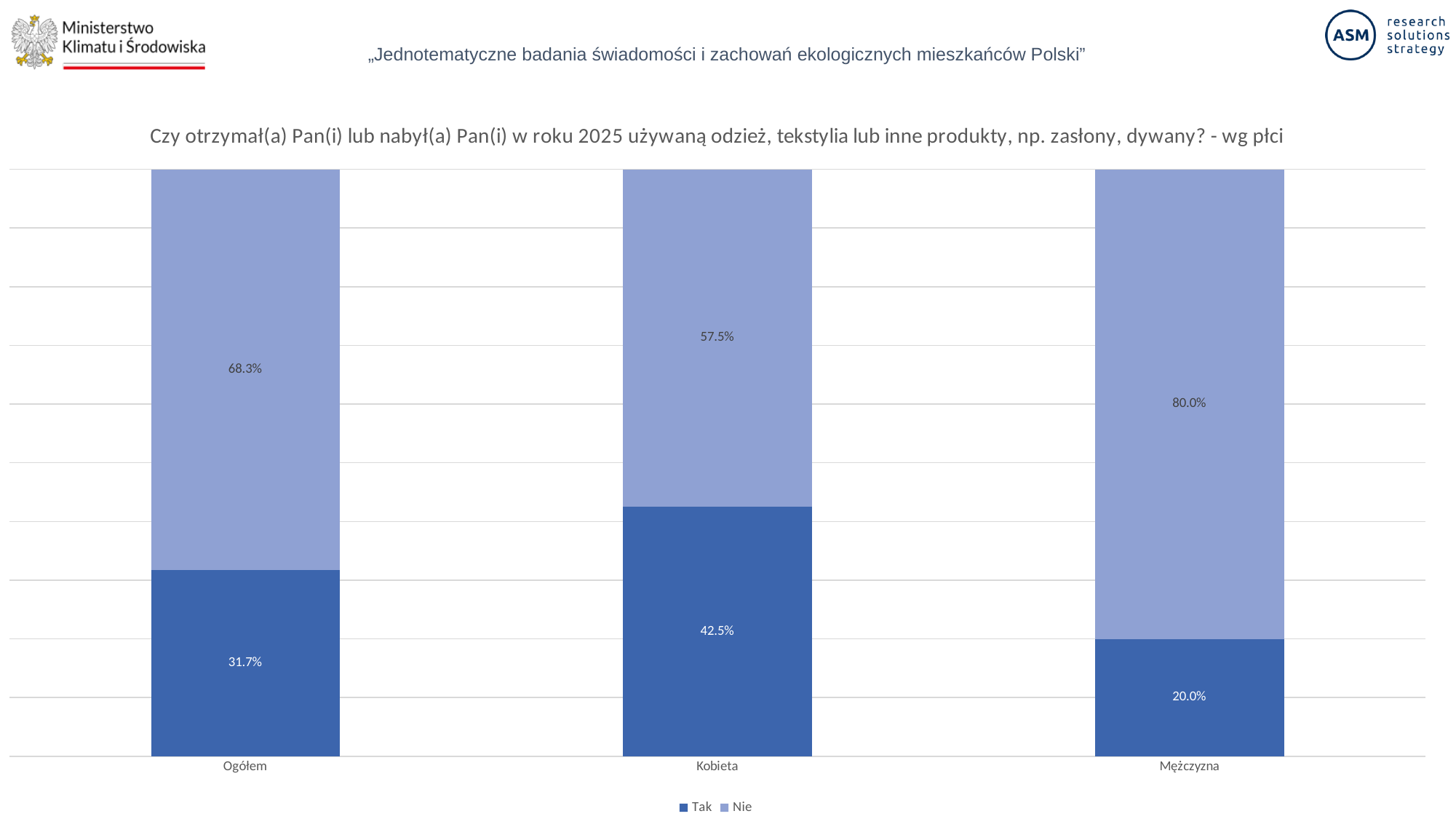
What is the value for "Tak" in the Ogółem category? 31.7% What is the value for "Tak" in the Kobieta category? 42.5% What is the difference between the "Tak" values for Kobieta and Mężczyzna? 22.5% What is the value for "Nie" in the Ogółem category? 68.3% What kind of chart is shown on the slide? Stacked bar chart Which category has the lowest value for "Nie"? Kobieta What is the total of the stacked bar for Mężczyzna? 100.0% What is the value for "Nie" in the Mężczyzna category? 80.0% Which category has the highest value for "Tak"? Kobieta Which is larger: the "Nie" value for Ogółem or the "Nie" value for Mężczyzna? Mężczyzna How many series does the legend list? 2 How many categories are shown on the x axis? 3